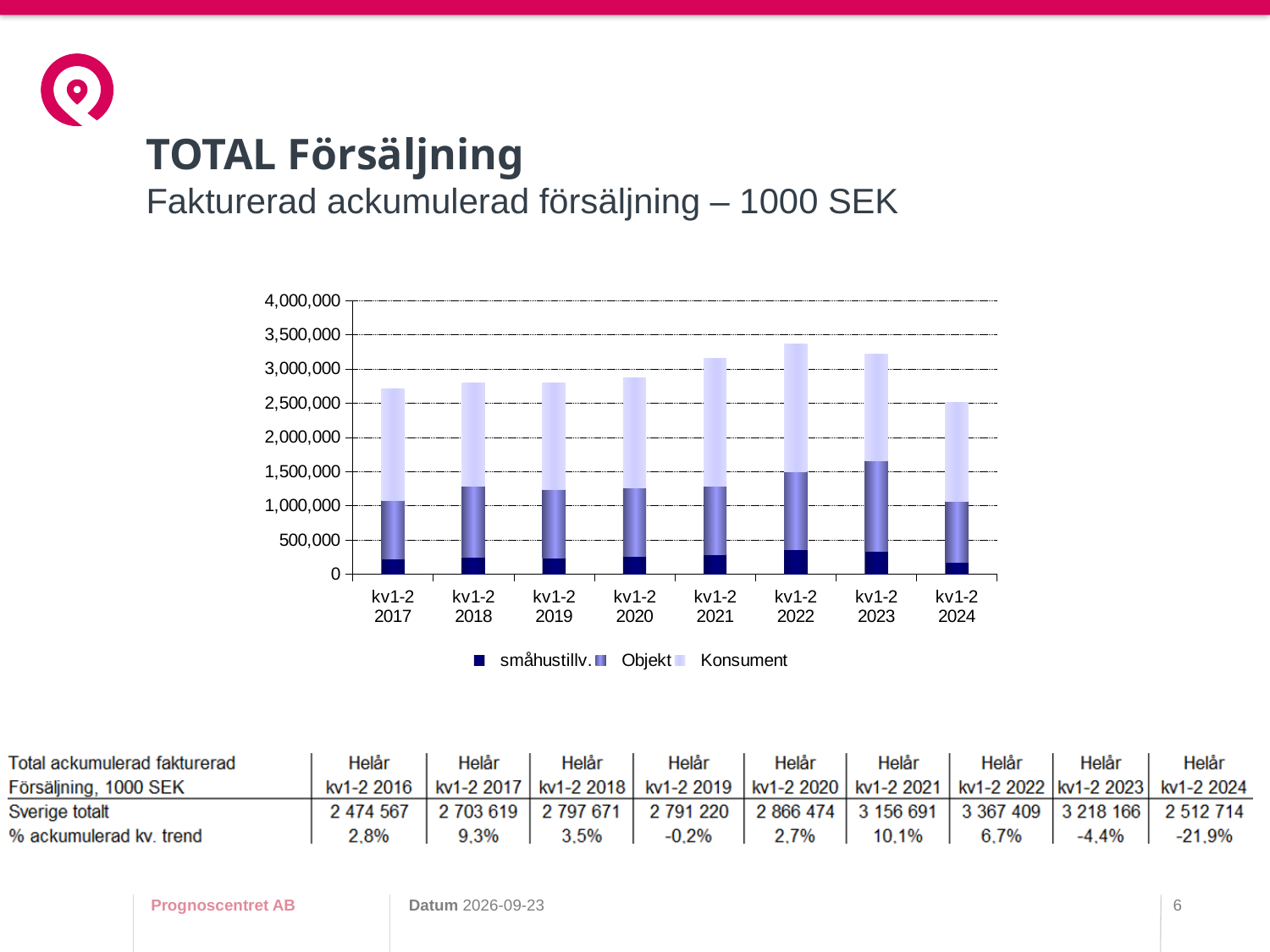
How many series does the chart legend list? 3 Is the total bar for kv1-2 2021 greater or less than 3,000,000? greater Is the total bar for kv1-2 2024 greater or less than 3,000,000? less What kind of chart is shown on the slide? Stacked bar chart Which period has the highest total bar in the chart? kv1-2 2022 Using the totals in the table, what is the difference between the kv1-2 2022 bar and the kv1-2 2024 bar? 854 695 According to the table, what is the total (Sverige totalt) for kv1-2 2024, the shortest bar in the chart? 2 512 714 What are the three series named in the chart legend? småhustillv., Objekt, Konsument Which total bar is taller, kv1-2 2022 or kv1-2 2023? kv1-2 2022 Which period has the lowest total bar in the chart? kv1-2 2024 How many periods (bars) are shown on the x axis of the chart? 8 According to the table, what is the total (Sverige totalt) for kv1-2 2022, the tallest bar in the chart? 3 367 409